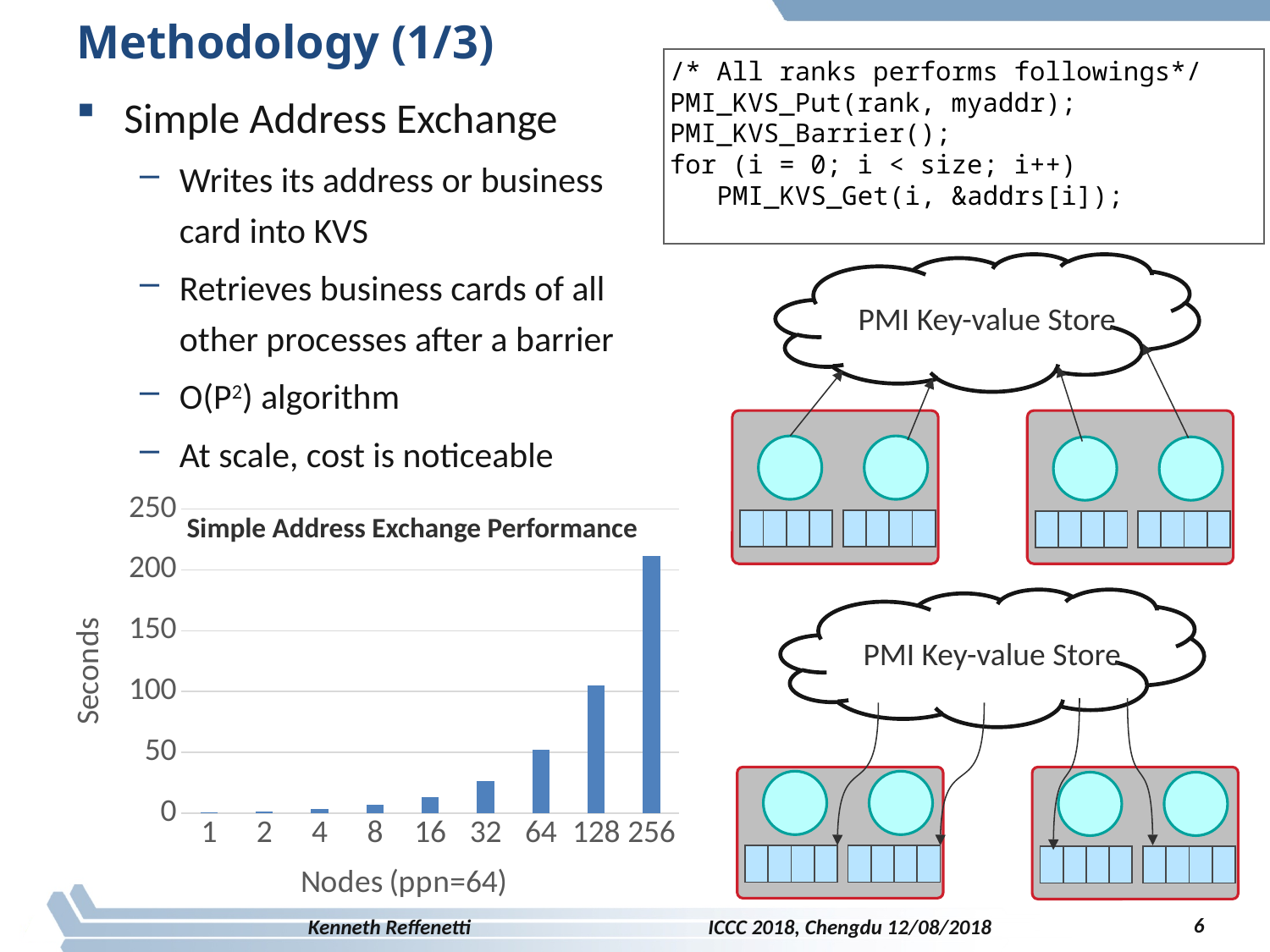
What kind of chart is shown on the slide? bar chart What is the title of the chart? Simple Address Exchange Performance Is the value for 128 nodes greater or less than 150? less How many node counts (categories) are plotted on the x axis of the chart? 9 Is the value for 256 nodes greater or less than 200? greater Which has a larger value, 128 nodes or 256 nodes? 256 Which node count has the highest value in the chart? 256 Which has a larger value, 16 nodes or 64 nodes? 64 What is the label of the y axis of the chart? Seconds Is the value for 32 nodes greater or less than 50? less Do the values rise or fall as the number of nodes increases along the x axis? rise